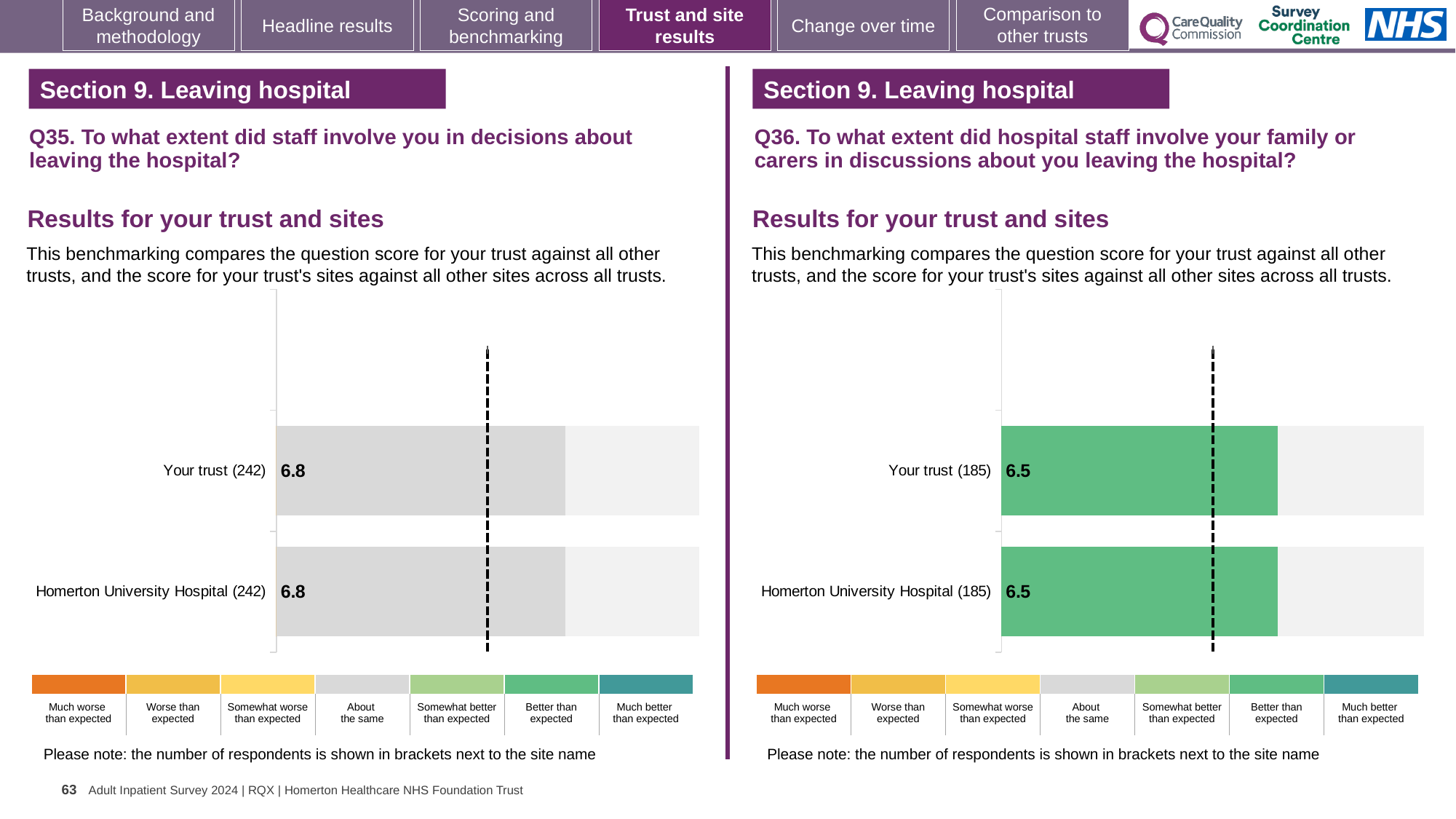
On the Q36 chart (right), what is the score for Your trust? 6.5 On the Q35 chart (left), how many respondents are shown in brackets for Your trust? 242 On the Q35 chart (left), what is the score for Homerton University Hospital? 6.8 How many bars are plotted on the Q36 chart (right)? 2 According to the colour key, which benchmark category do the green bars on the Q36 chart (right) represent? Better than expected On the Q35 chart (left), what is the difference between the score for Your trust and the score for Homerton University Hospital? 0 How many bars are plotted on the Q35 chart (left)? 2 On the Q35 chart (left), what is the score for Your trust? 6.8 What type of chart is used on the Q36 chart (right)? Bar chart On the Q36 chart (right), what is the difference between the score for Your trust and the score for Homerton University Hospital? 0 On the Q36 chart (right), how many respondents are shown in brackets for Homerton University Hospital? 185 On the Q36 chart (right), what is the score for Homerton University Hospital? 6.5